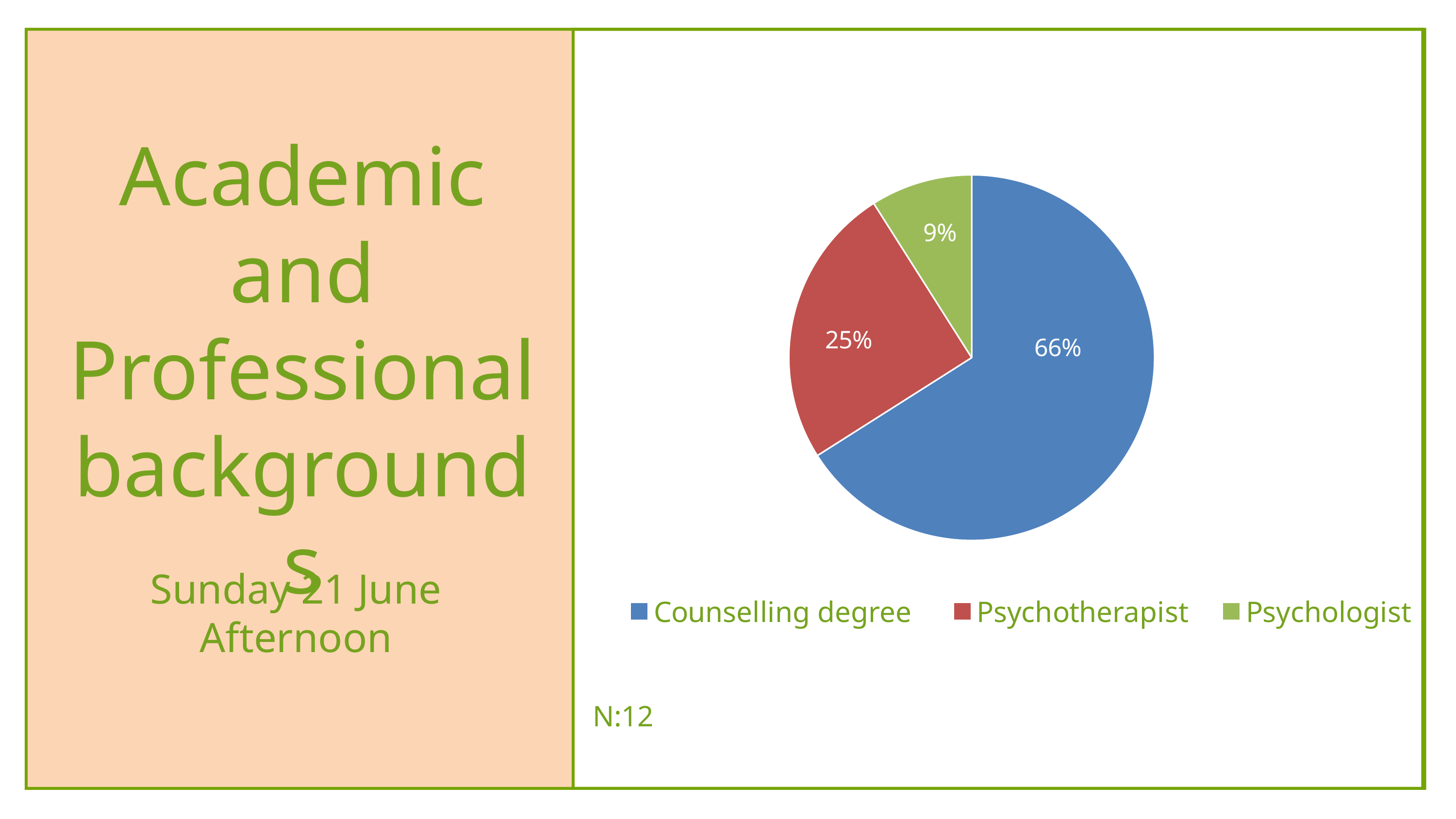
Which category has the smallest share of the pie? Psychologist What sample size (N) is stated below the chart? 12 Which category has the largest share of the pie? Counselling degree What percentage of the pie is Psychotherapist? 25% How many entries does the legend list? 3 How many slices does the pie chart have? 3 Which is larger, the share for Psychotherapist or the share for Psychologist? Psychotherapist What percentage of the pie is Psychologist? 9% What is the difference in percentage points between Counselling degree and Psychotherapist? 41 What colour is the Psychotherapist slice? red What kind of chart is shown on the slide? pie chart What percentage of the pie is Counselling degree? 66%